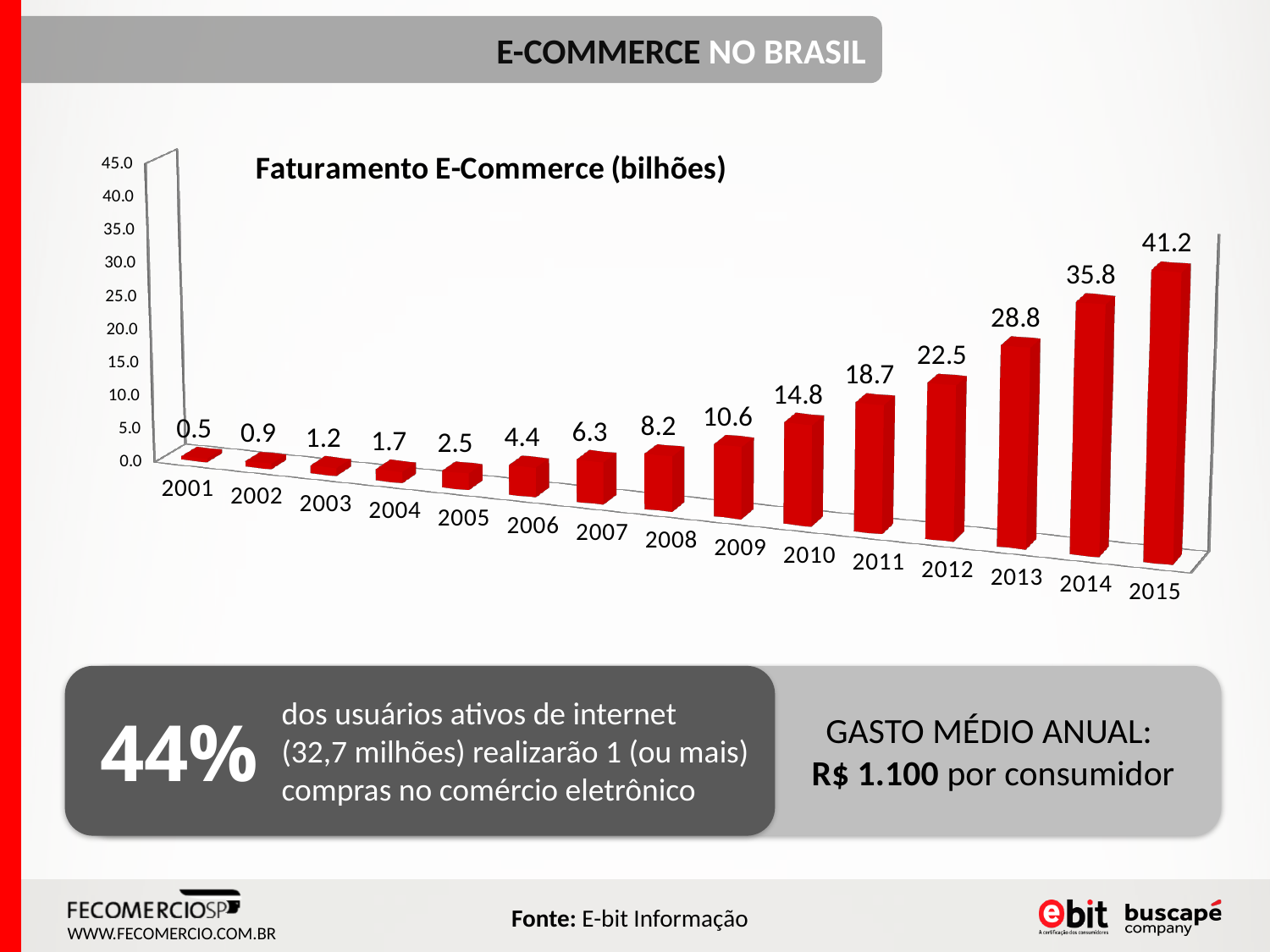
What is the difference between the values for 2015 and 2014 in the Faturamento E-Commerce (bilhões) chart? 5.4 What is the value for 2006 in the Faturamento E-Commerce (bilhões) chart? 4.4 What is the value for 2013 in the Faturamento E-Commerce (bilhões) chart? 28.8 How many years are shown in the Faturamento E-Commerce (bilhões) chart? 15 What kind of chart is the Faturamento E-Commerce (bilhões) chart? bar chart What is the value for 2010 in the Faturamento E-Commerce (bilhões) chart? 14.8 Which year has the lowest value in the Faturamento E-Commerce (bilhões) chart? 2001 Which year has the highest value in the Faturamento E-Commerce (bilhões) chart? 2015 Do the values in the Faturamento E-Commerce (bilhões) chart rise or fall from 2001 to 2015? rise Which is larger in the Faturamento E-Commerce (bilhões) chart, the value for 2008 or the value for 2009? 2009 What is the difference between the values for 2012 and 2011 in the Faturamento E-Commerce (bilhões) chart? 3.8 Is the value for 2013 in the Faturamento E-Commerce (bilhões) chart greater or less than 25.0? greater